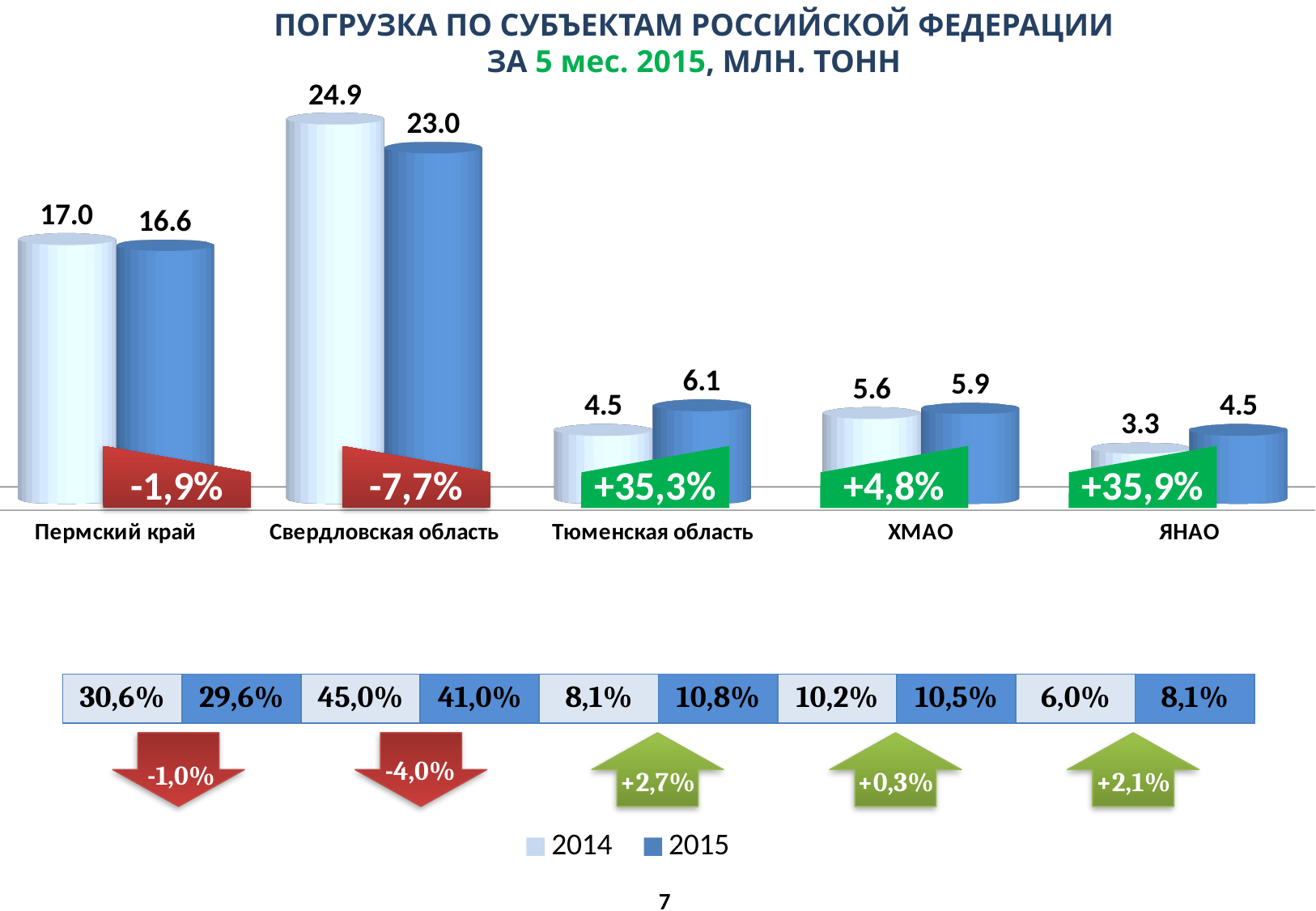
What is the 2015 value for Свердловская область? 23.0 What kind of chart is shown on the slide? bar chart How many series does the legend list? 2 What is the 2015 share shown in the table for Свердловская область? 41,0% What is the 2015 value for Тюменская область? 6.1 How many regions are shown on the x axis? 5 What is the difference between the 2014 and 2015 values for Пермский край? 0.4 Which region has the highest 2014 value? Свердловская область Which region has the lowest 2015 value? ЯНАО Which is larger for ХМАО: the 2014 value or the 2015 value? 2015 What is the 2014 value for ЯНАО? 3.3 What percentage change is shown for Тюменская область between 2014 and 2015? +35,3%